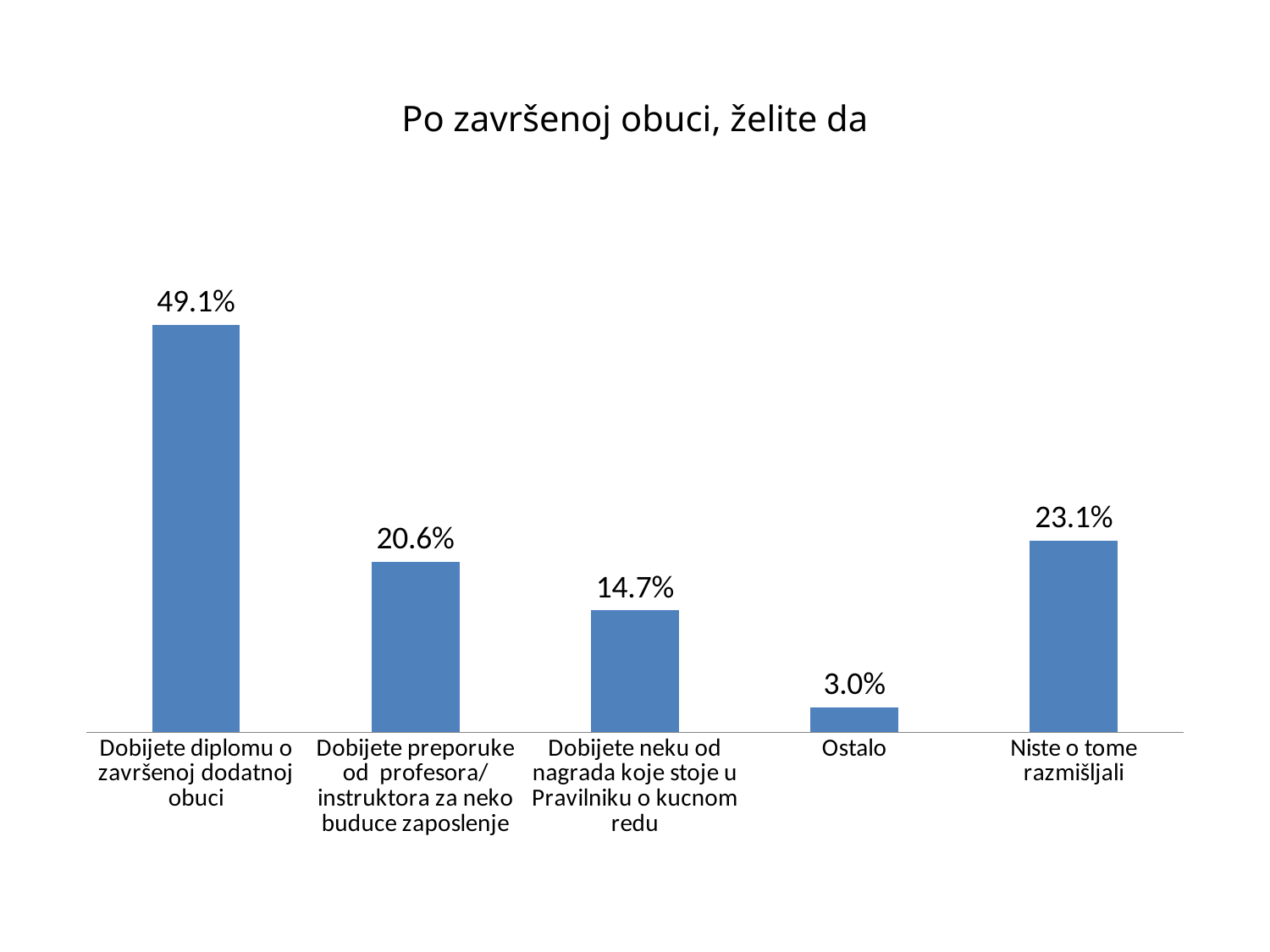
What is the value for "Dobijete diplomu o završenoj dodatnoj obuci"? 49.1% How many categories are shown in the chart? 5 What kind of chart is shown on the slide? Bar chart Which category has the highest value? Dobijete diplomu o završenoj dodatnoj obuci What is the value for "Dobijete neku od nagrada koje stoje u Pravilniku o kucnom redu"? 14.7% What is the value for "Ostalo"? 3.0% What is the difference between the values for "Dobijete preporuke od profesora/instruktora za neko buduce zaposlenje" and "Dobijete neku od nagrada koje stoje u Pravilniku o kucnom redu"? 5.9% What is the value for "Niste o tome razmišljali"? 23.1% What is the title of the chart? Po završenoj obuci, želite da Which category has the lowest value? Ostalo Which is larger, the value for "Niste o tome razmišljali" or the value for "Dobijete preporuke od profesora/instruktora za neko buduce zaposlenje"? Niste o tome razmišljali What is the difference between the values for "Dobijete diplomu o završenoj dodatnoj obuci" and "Niste o tome razmišljali"? 26.0%